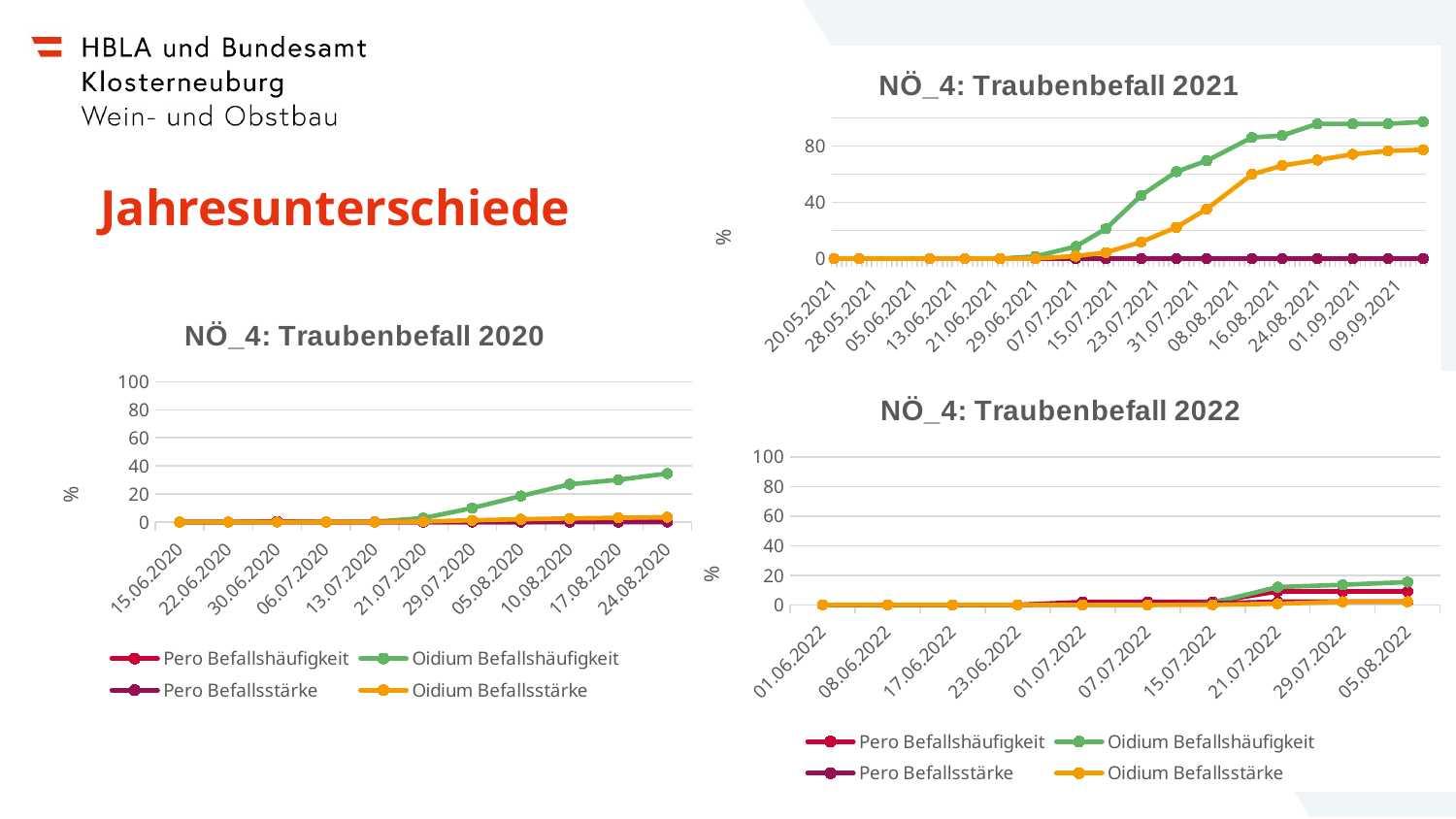
How many series does the legend of "NÖ_4: Traubenbefall 2020" list? 4 In "NÖ_4: Traubenbefall 2022", is the value for Oidium Befallshäufigkeit on 05.08.2022 greater or less than 20? less In "NÖ_4: Traubenbefall 2020", is the value for Oidium Befallshäufigkeit on 24.08.2020 greater or less than 40? less How many dates are shown on the x axis of "NÖ_4: Traubenbefall 2021"? 15 In "NÖ_4: Traubenbefall 2020", which series reaches the highest value on 24.08.2020? Oidium Befallshäufigkeit In "NÖ_4: Traubenbefall 2021", which line is higher on 09.09.2021, the green line or the orange line? the green line How many dates are shown on the x axis of "NÖ_4: Traubenbefall 2022"? 10 What kind of chart is "NÖ_4: Traubenbefall 2020"? line chart In "NÖ_4: Traubenbefall 2021", does the green line rise or fall from 29.06.2021 to 09.09.2021? rise In "NÖ_4: Traubenbefall 2020", is the value for Oidium Befallshäufigkeit on 24.08.2020 greater or less than 20? greater How many dates are shown on the x axis of "NÖ_4: Traubenbefall 2020"? 11